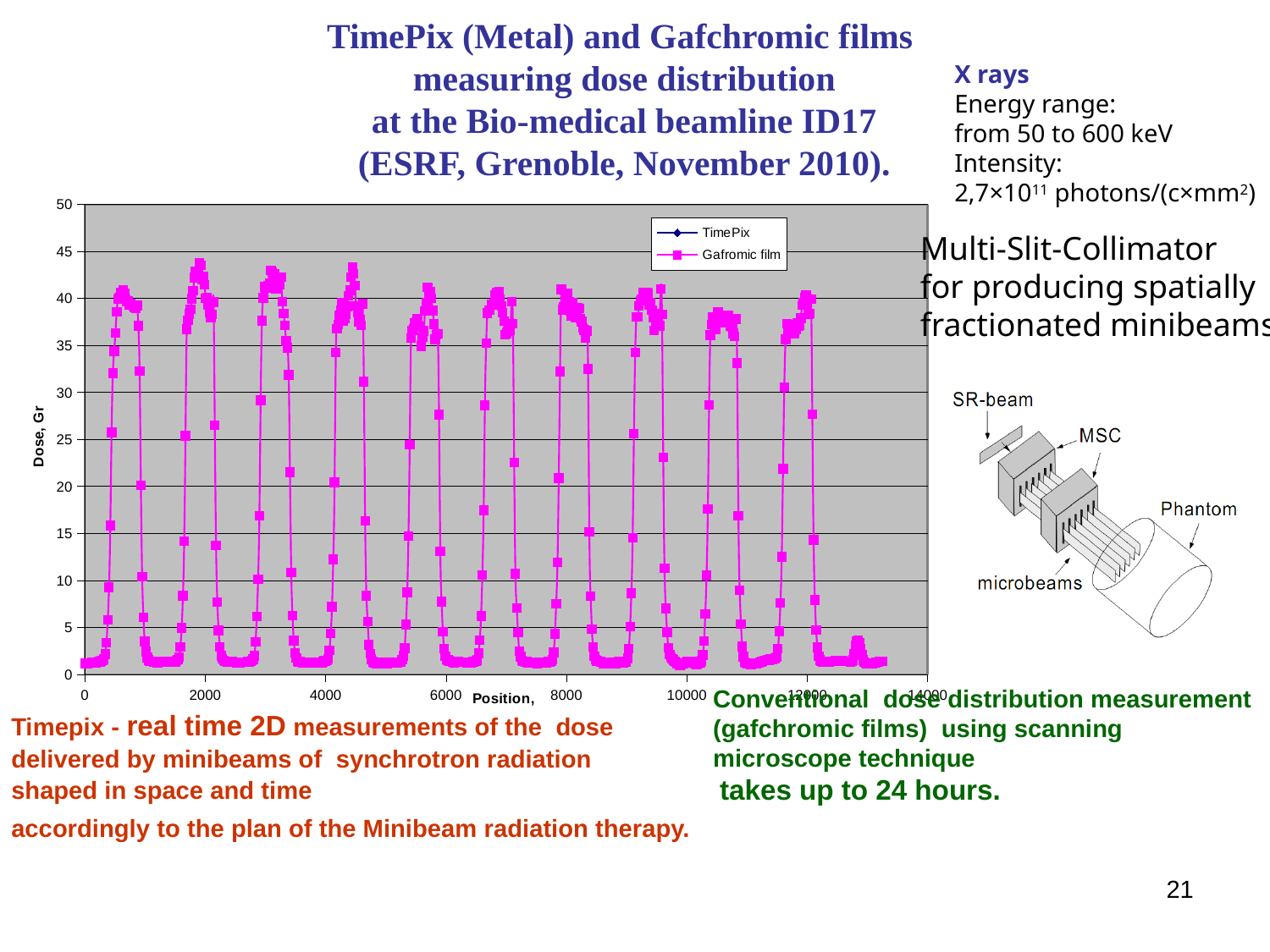
Does the dose rise steadily, fall steadily, or alternate between peaks and valleys along the position axis? alternates between peaks and valleys Is the dose at the peaks of the curve greater or less than 35? greater What are the two series named in the chart legend? TimePix and Gafromic film What kind of chart is shown on the slide? line chart What is the highest tick value shown on the vertical axis of the chart? 50 Is the dose at the peaks of the curve greater or less than 50? less Is the dose in the valleys between the peaks greater or less than 5? less What is the highest tick value shown on the horizontal axis of the chart? 14000 How many series does the chart legend list? 2 What is the label of the vertical axis of the chart? Dose, Gr